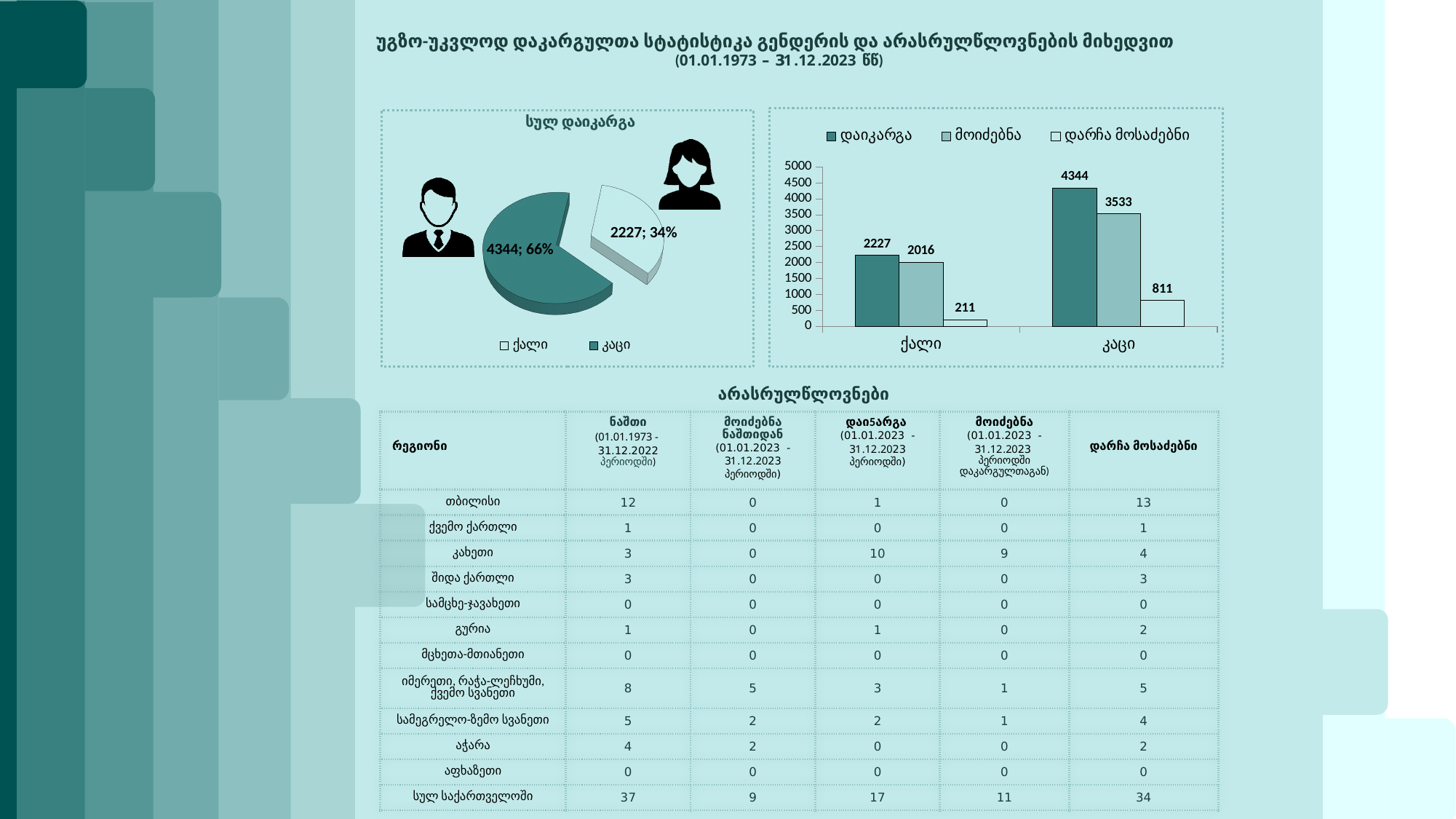
In the pie chart titled "სულ დაიკარგა", what value and share are shown for the კაცი slice? 4344; 66% What kind of chart is the chart on the left titled "სულ დაიკარგა"? Pie chart In the pie chart titled "სულ დაიკარგა", which slice is larger, ქალი or კაცი? კაცი In the bar chart on the right, how many categories are shown on the x axis? 2 In the bar chart on the right, what is the value of მოიძებნა for ქალი? 2016 In the bar chart on the right, what is the value of დაიკარგა for კაცი? 4344 In the bar chart on the right, what is the difference between დაიკარგა and მოიძებნა for ქალი? 211 What kind of chart is the chart on the right of the slide? Bar chart In the bar chart on the right, what is the value of დარჩა მოსაძებნი for კაცი? 811 In the bar chart on the right, which category has the lowest value for დარჩა მოსაძებნი? ქალი In the bar chart on the right, how many series does the legend list? 3 In the pie chart titled "სულ დაიკარგა", what share of the pie does the ქალი slice represent? 34%